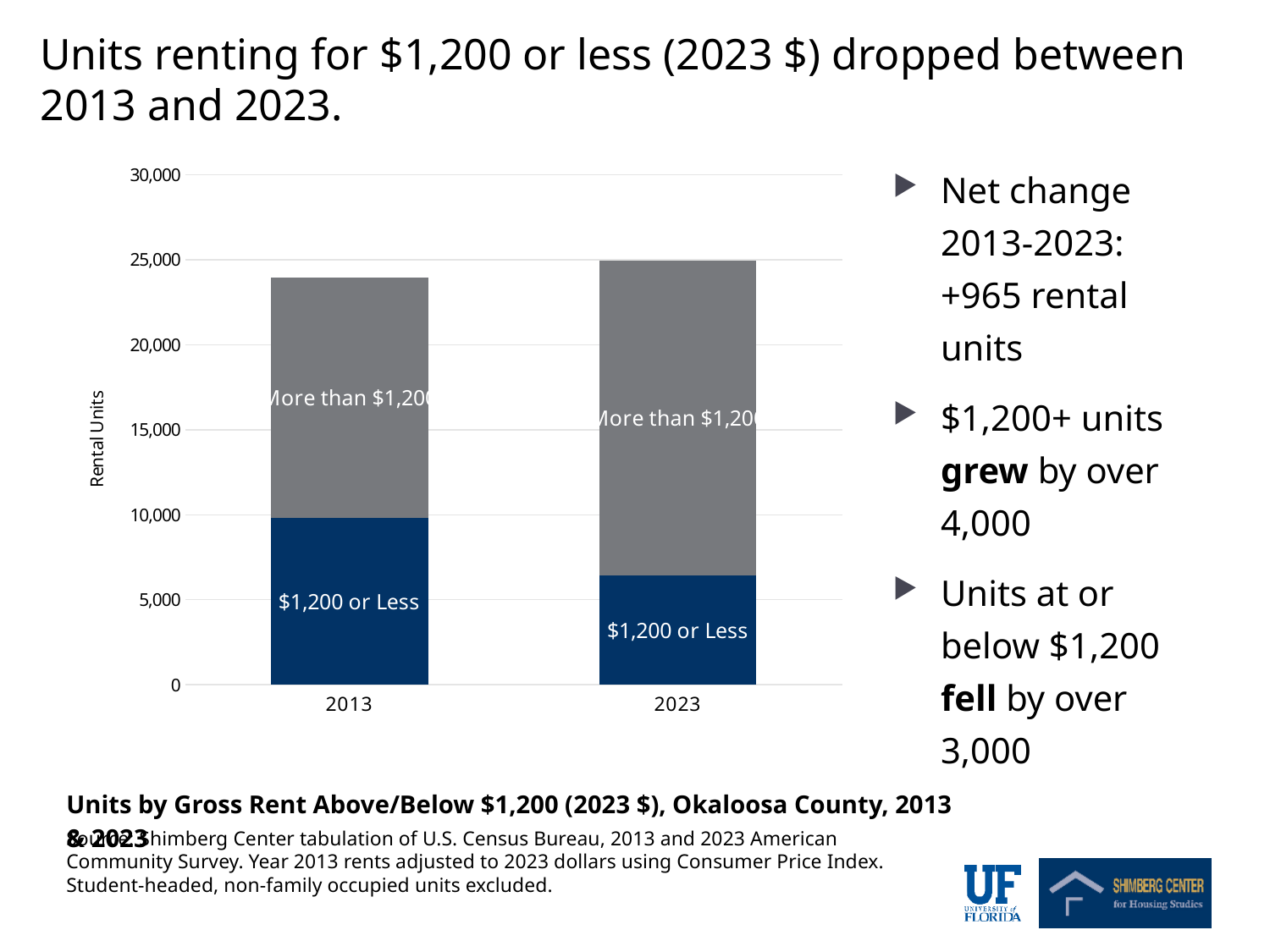
How many years (categories) are shown on the x axis of the chart? 2 Does the number of units renting for $1,200 or less rise or fall from 2013 to 2023? Fall Which county does the chart title say the data is for? Okaloosa County Is the number of units renting for $1,200 or less in 2013 greater or less than 5,000? greater Which year has the larger number of units renting for $1,200 or less, 2013 or 2023? 2013 What kind of chart is shown on the slide? Stacked bar chart Is the total height of the 2013 bar greater or less than 25,000? less What is the label on the vertical axis of the chart? Rental Units Is the total height of the 2023 bar greater or less than 20,000? greater Which year has the taller total bar, 2013 or 2023? 2023 How many rent segments are stacked in each bar of the chart? 2